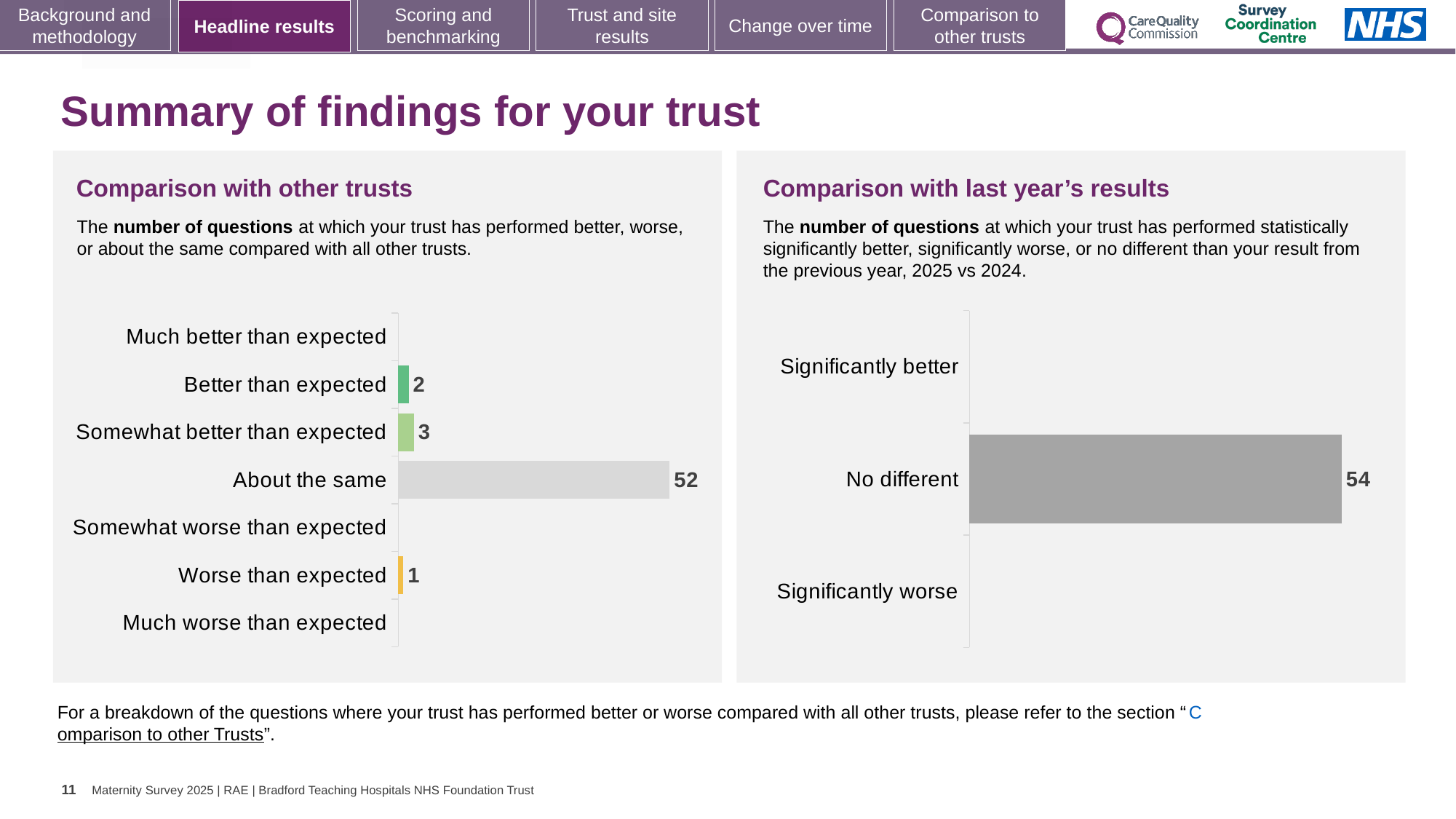
How many categories are listed on the 'Comparison with last year's results' chart? 3 What type of chart is the 'Comparison with last year's results' chart? Bar chart In the 'Comparison with other trusts' chart, what is the value for 'Worse than expected'? 1 In the 'Comparison with other trusts' chart, how many questions are 'About the same'? 52 In the 'Comparison with other trusts' chart, what is the value for 'Better than expected'? 2 In the 'Comparison with other trusts' chart, which is larger: 'Somewhat better than expected' or 'Better than expected'? Somewhat better than expected How many categories are listed on the 'Comparison with other trusts' chart? 7 In the 'Comparison with other trusts' chart, which category has the highest value? About the same In the 'Comparison with other trusts' chart, what is the value for 'Somewhat better than expected'? 3 In the 'Comparison with other trusts' chart, what colour is the 'Worse than expected' bar? Orange In the 'Comparison with last year's results' chart, what is the value for 'No different'? 54 In the 'Comparison with other trusts' chart, what is the difference between 'About the same' and 'Somewhat better than expected'? 49